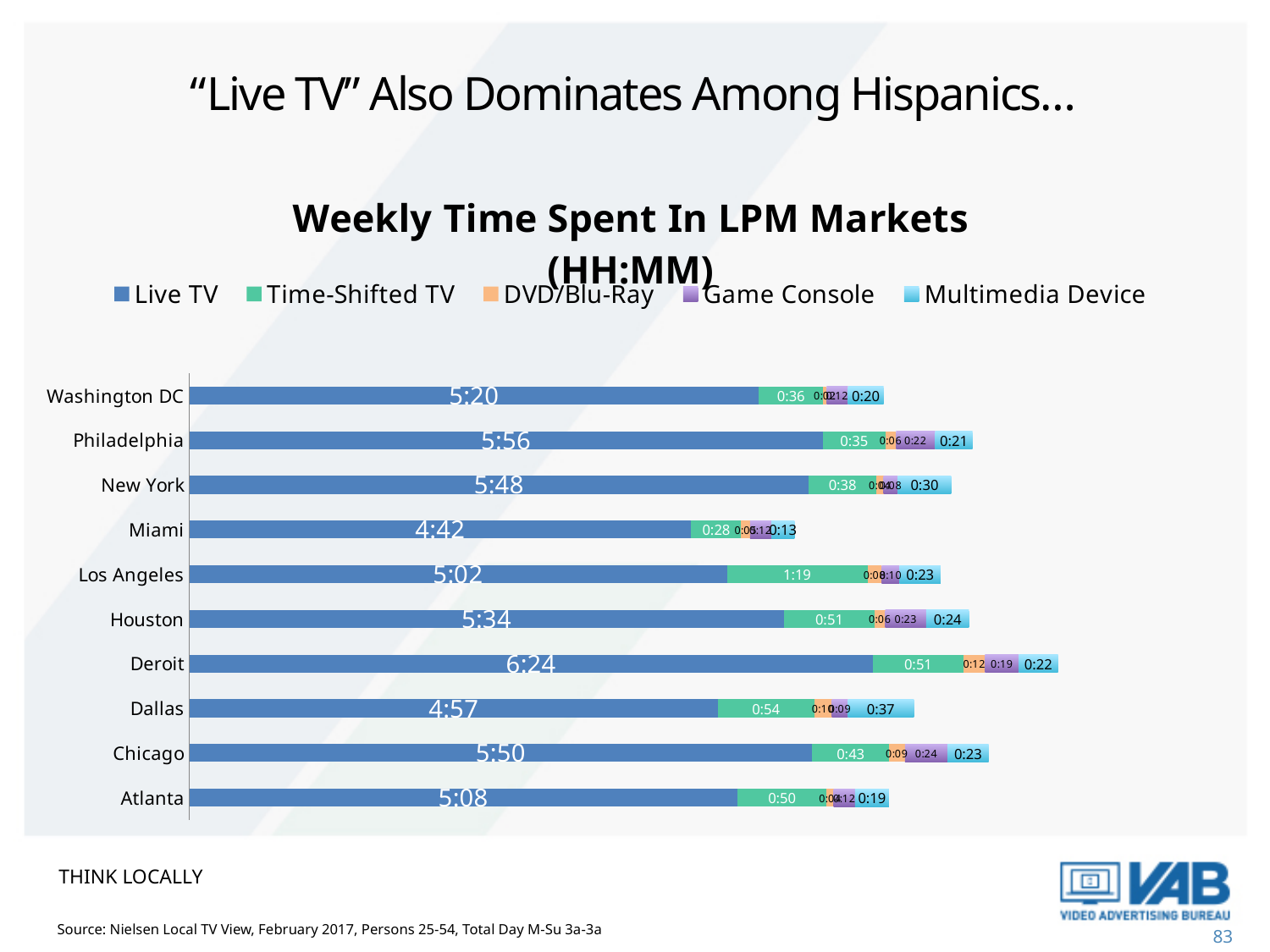
Which has a larger Live TV value, Houston or Atlanta? Houston How many markets are shown in the chart? 10 What is the Live TV value for Deroit? 6:24 What is the Time-Shifted TV value for Los Angeles? 1:19 Which series is shown in orange in the legend? DVD/Blu-Ray How many series does the legend list? 5 Which market has the lowest Live TV value? Miami What is the difference between the Live TV values for Philadelphia and Miami? 1:14 What is the Multimedia Device value for Dallas? 0:37 Which market has the highest Time-Shifted TV value? Los Angeles Which market has the highest Live TV value? Deroit What kind of chart is shown on the slide? Stacked bar chart